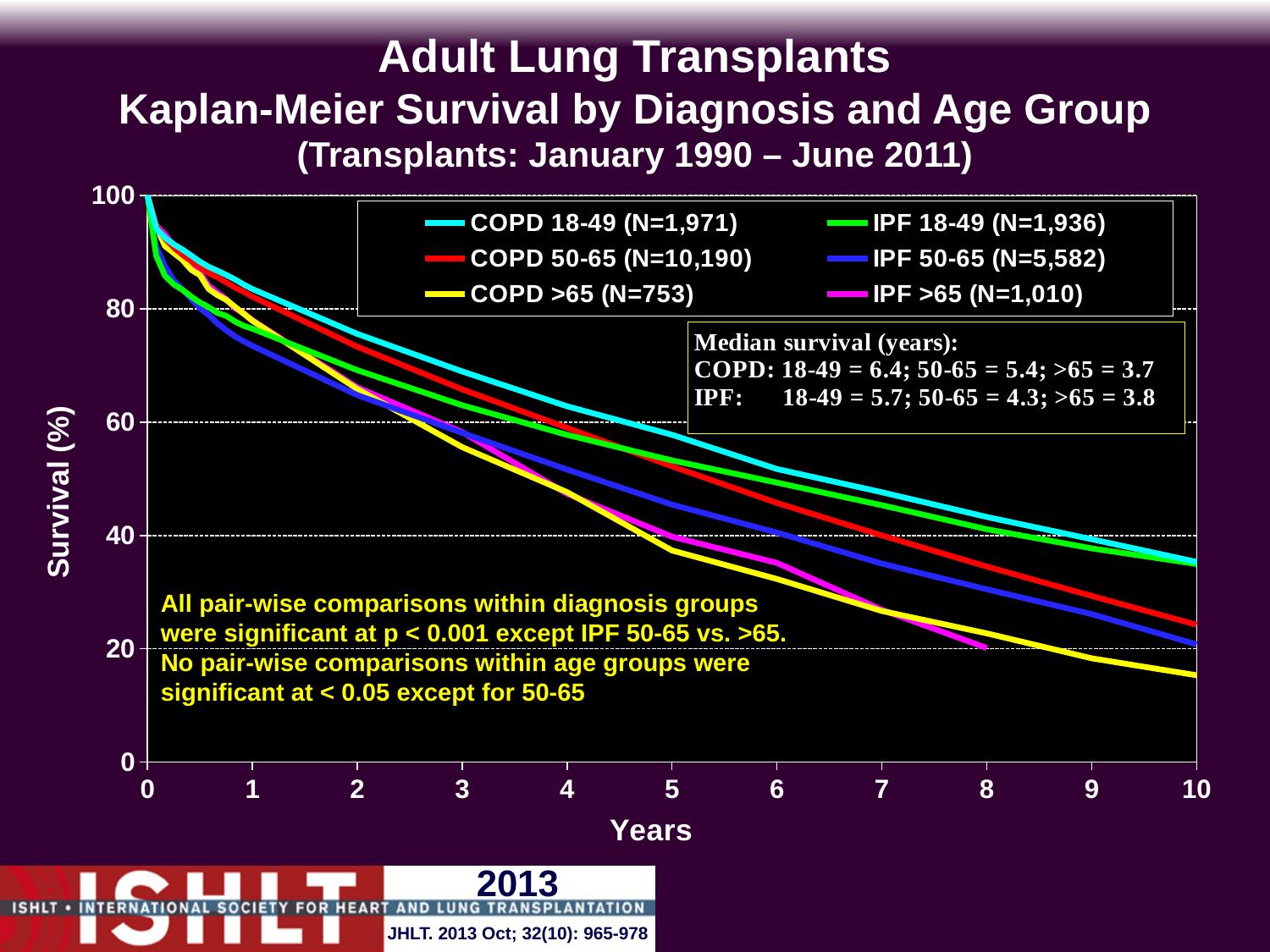
Do the survival curves rise or fall as years increase? fall Which diagnosis/age group has the highest median survival listed in the text box? COPD 18-49 Is the survival for COPD 18-49 at 10 years greater or less than 40? less How many series does the legend list? 6 Which series has the lowest survival at 10 years? COPD >65 Is the survival for COPD >65 at 10 years greater or less than 20? less What is the difference in median survival (years) between COPD 18-49 and IPF 18-49 as given in the text box? 0.7 According to the text box, what is the median survival in years for IPF 50-65? 4.3 What is the N for the COPD 50-65 group shown in the legend? 10,190 Is the survival for IPF 50-65 at 1 year greater or less than 80? less What kind of chart is shown on the slide? line chart According to the text box, what is the median survival in years for COPD 18-49? 6.4